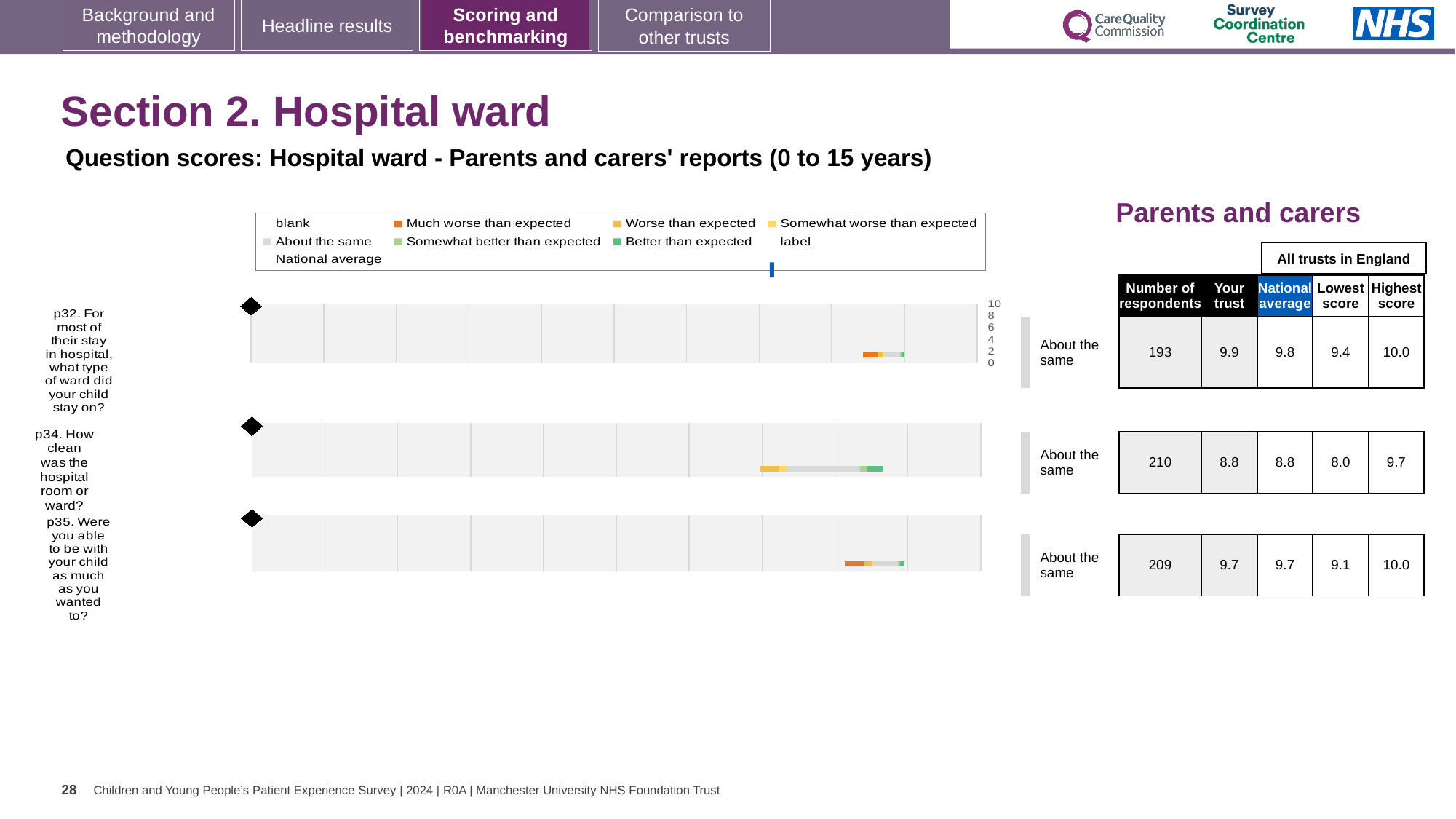
Is the 'Your trust' score for p35 higher or lower than the 'Your trust' score for p34? higher What is the 'Your trust' score for p32 (what type of ward did your child stay on)? 9.9 What benchmark category is shown for p32, p34 and p35? About the same How many respondents answered p34? 210 What is the national average score for p35 (were you able to be with your child as much as you wanted to)? 9.7 Which of the three questions has the highest 'Your trust' score? p32 Is the 'Your trust' score for p34 greater or less than 8 on the chart axis? greater What is the difference between the 'Your trust' scores for p32 and p34? 1.1 Which of the three questions has the lowest 'Your trust' score? p34 How many survey questions (chart rows) are plotted on this slide? 3 What is the 'Your trust' score for p34 (how clean was the hospital room or ward)? 8.8 What kind of chart is used to show the question scores on this slide? bar chart